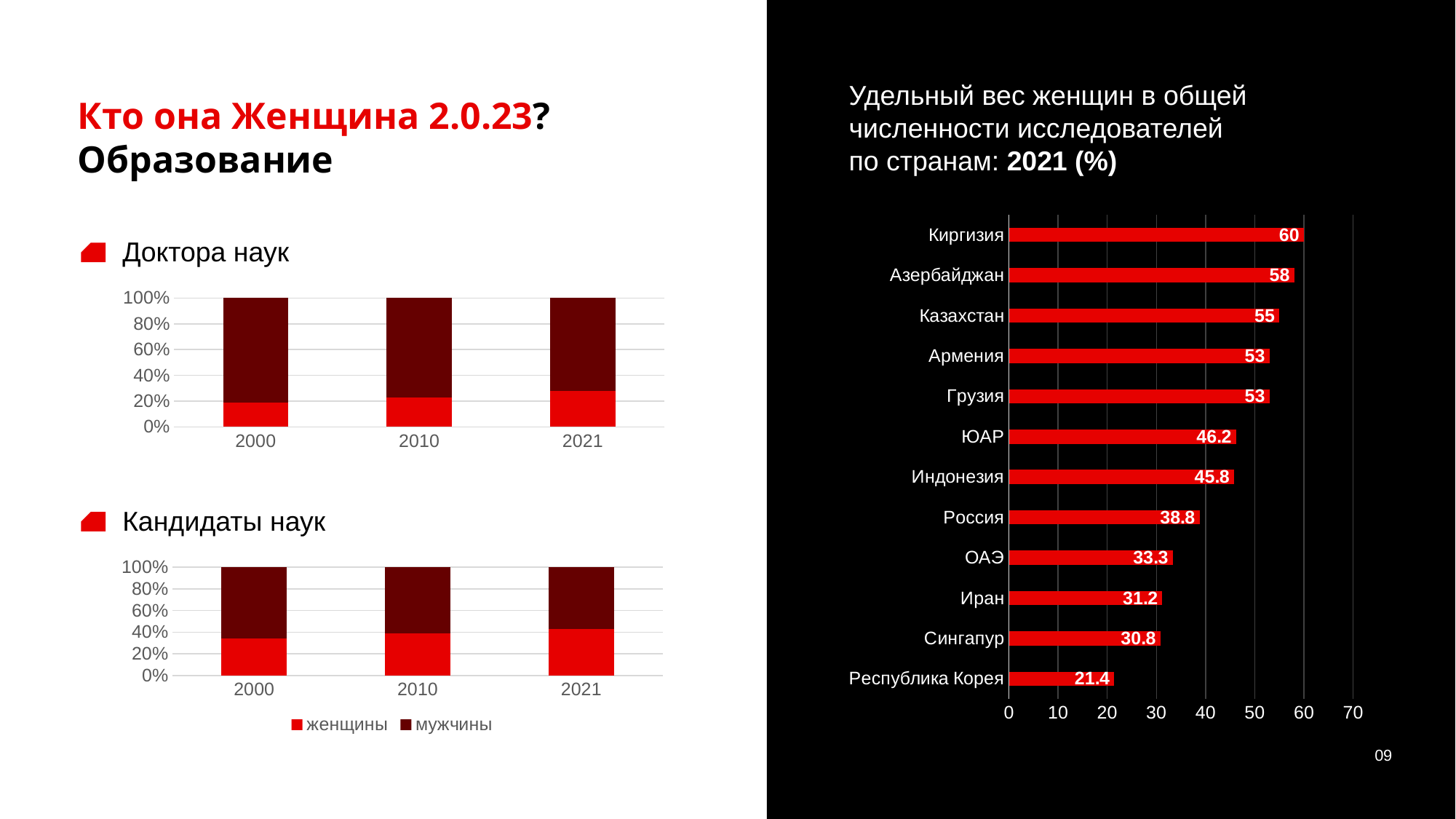
In the chart 'Удельный вес женщин в общей численности исследователей по странам: 2021 (%)', which country has the lowest value? Республика Корея In the chart 'Удельный вес женщин в общей численности исследователей по странам: 2021 (%)', what is the value for Индонезия? 45.8 In the chart 'Удельный вес женщин в общей численности исследователей по странам: 2021 (%)', what is the difference between the values for Киргизия and Республика Корея? 38.6 How many series does the legend under the 'Кандидаты наук' chart list? 2 In the chart 'Удельный вес женщин в общей численности исследователей по странам: 2021 (%)', which is larger, the value for ОАЭ or the value for Сингапур? ОАЭ In the 'Кандидаты наук' chart, is the value for женщины in 2021 greater or less than 40%? greater In the chart 'Удельный вес женщин в общей численности исследователей по странам: 2021 (%)', which country has the highest value? Киргизия In the chart 'Удельный вес женщин в общей численности исследователей по странам: 2021 (%)', how many countries are shown? 12 In the chart 'Удельный вес женщин в общей численности исследователей по странам: 2021 (%)', what is the value for Россия? 38.8 In the 'Кандидаты наук' chart, does the share of женщины rise or fall from 2000 to 2021? rise What kind of chart is 'Удельный вес женщин в общей численности исследователей по странам: 2021 (%)'? bar chart